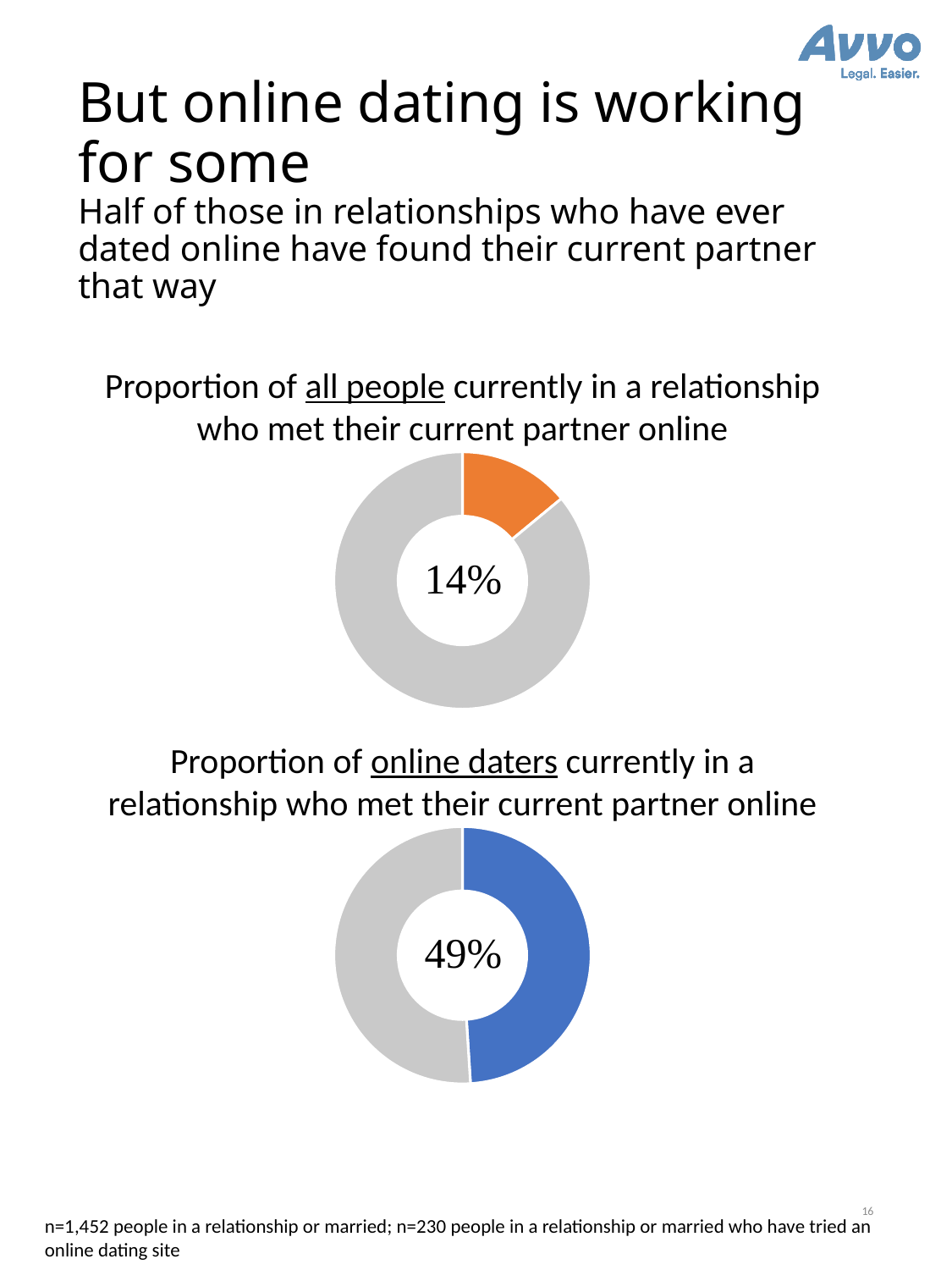
What kind of chart is used for the top chart on the slide? Donut (pie) chart What kind of chart is used for the bottom chart on the slide? Donut (pie) chart What is the difference in percentage points between the bottom chart's value (49%) and the top chart's value (14%)? 35 percentage points How many slices does the top donut chart have? 2 Which is larger: the percentage in the top chart (all people) or the percentage in the bottom chart (online daters)? The bottom chart (online daters), 49% How many slices does the bottom donut chart have? 2 In the top chart, is the highlighted value greater or less than 25%? less In the bottom chart, is the highlighted value greater or less than 25%? greater In the bottom chart, 'Proportion of online daters currently in a relationship who met their current partner online', what percentage is shown? 49% In the top chart, 'Proportion of all people currently in a relationship who met their current partner online', what percentage is shown? 14% What colour is the highlighted slice in the top chart? Orange What colour is the highlighted slice in the bottom chart? Blue